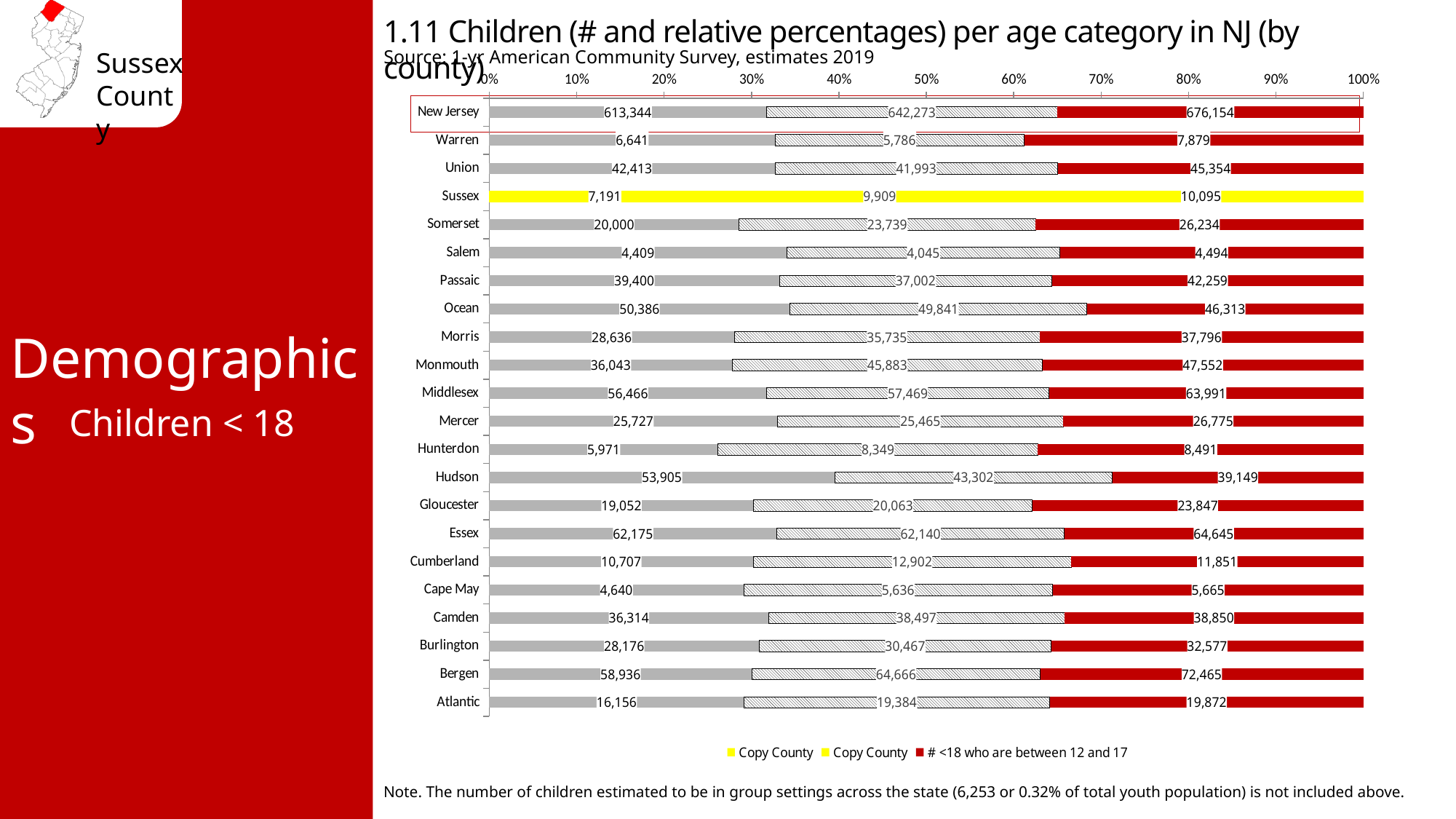
What is the value of the first (leftmost) segment for New Jersey? 613,344 Which row in the chart is highlighted in yellow? Sussex What is the difference between the third segment (10,095) and the first segment (7,191) for Sussex? 2,904 What is the value of the first (leftmost) segment for Hudson? 53,905 Excluding the New Jersey row, which county has the largest value in the '# <18 who are between 12 and 17' series? Bergen What is the value of the middle (hatched) segment for Bergen? 64,666 For Ocean, which is larger: the first segment (50,386) or the '# <18 who are between 12 and 17' segment (46,313)? the first segment (50,386) What is the total of the three segments for Sussex? 27,195 How many series does the chart legend list? 3 What is the value for Sussex in the '# <18 who are between 12 and 17' series? 10,095 How many rows (New Jersey plus counties) are plotted in the chart? 22 What kind of chart is shown on the slide? bar chart